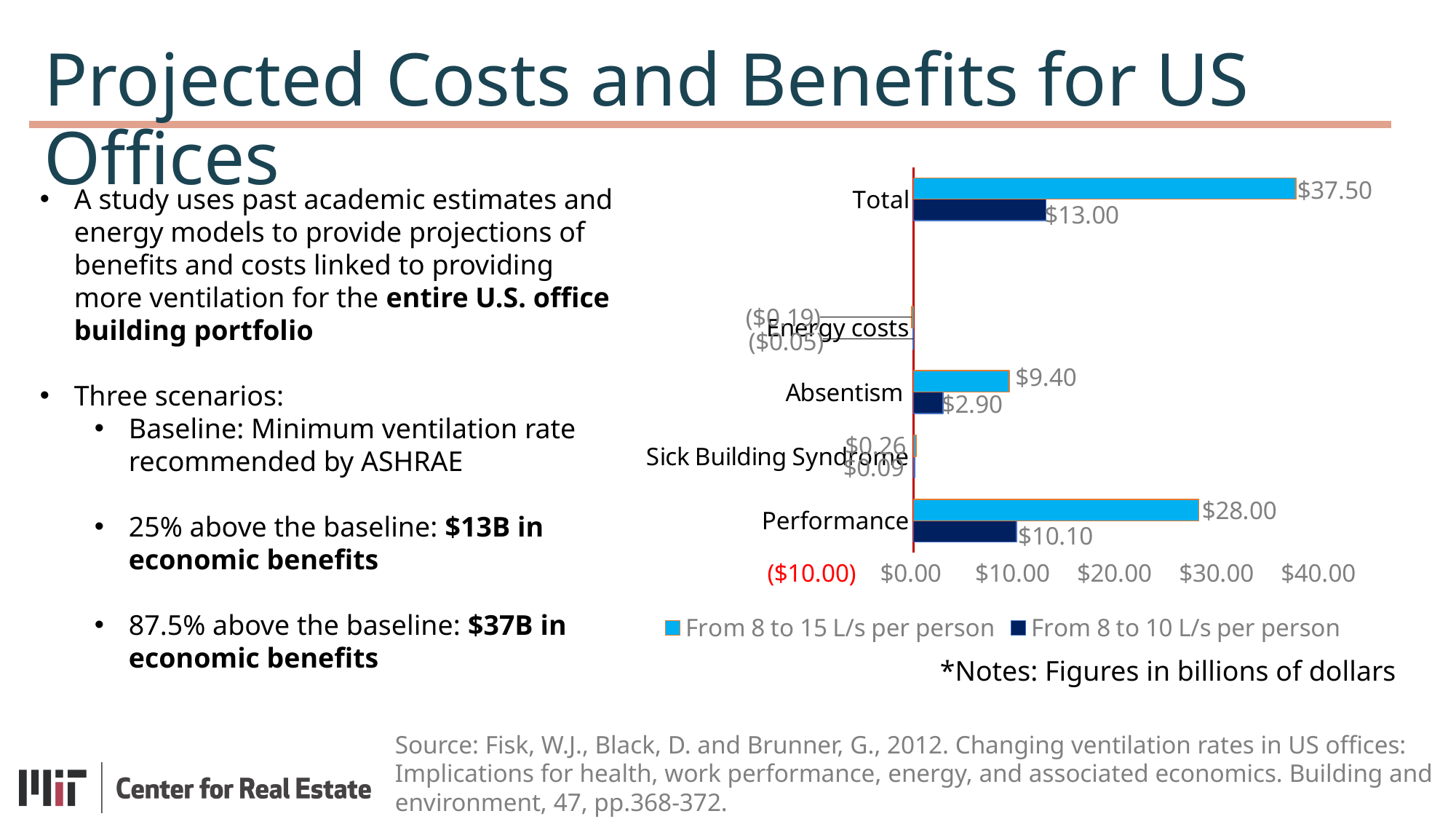
How many series does the legend list? 2 What is the difference between the Total values of the two series ($37.50 and $13.00)? $24.50 What kind of chart is shown on the slide? Bar chart What is the value for Total in the 'From 8 to 15 L/s per person' series? $37.50 Which category has the lowest value in the 'From 8 to 10 L/s per person' series? Energy costs Excluding Total, which category has the highest value in the 'From 8 to 15 L/s per person' series? Performance What is the value for Absentism in the 'From 8 to 15 L/s per person' series? $9.40 What is the value for Absentism in the 'From 8 to 10 L/s per person' series? $2.90 How many categories are shown on the chart? 5 What is the difference between the Performance values of the two series ($28.00 and $10.10)? $17.90 Which is larger: the Performance value for 'From 8 to 15 L/s per person' or the Total value for 'From 8 to 10 L/s per person'? Performance for 'From 8 to 15 L/s per person' What is the value for Performance in the 'From 8 to 10 L/s per person' series? $10.10